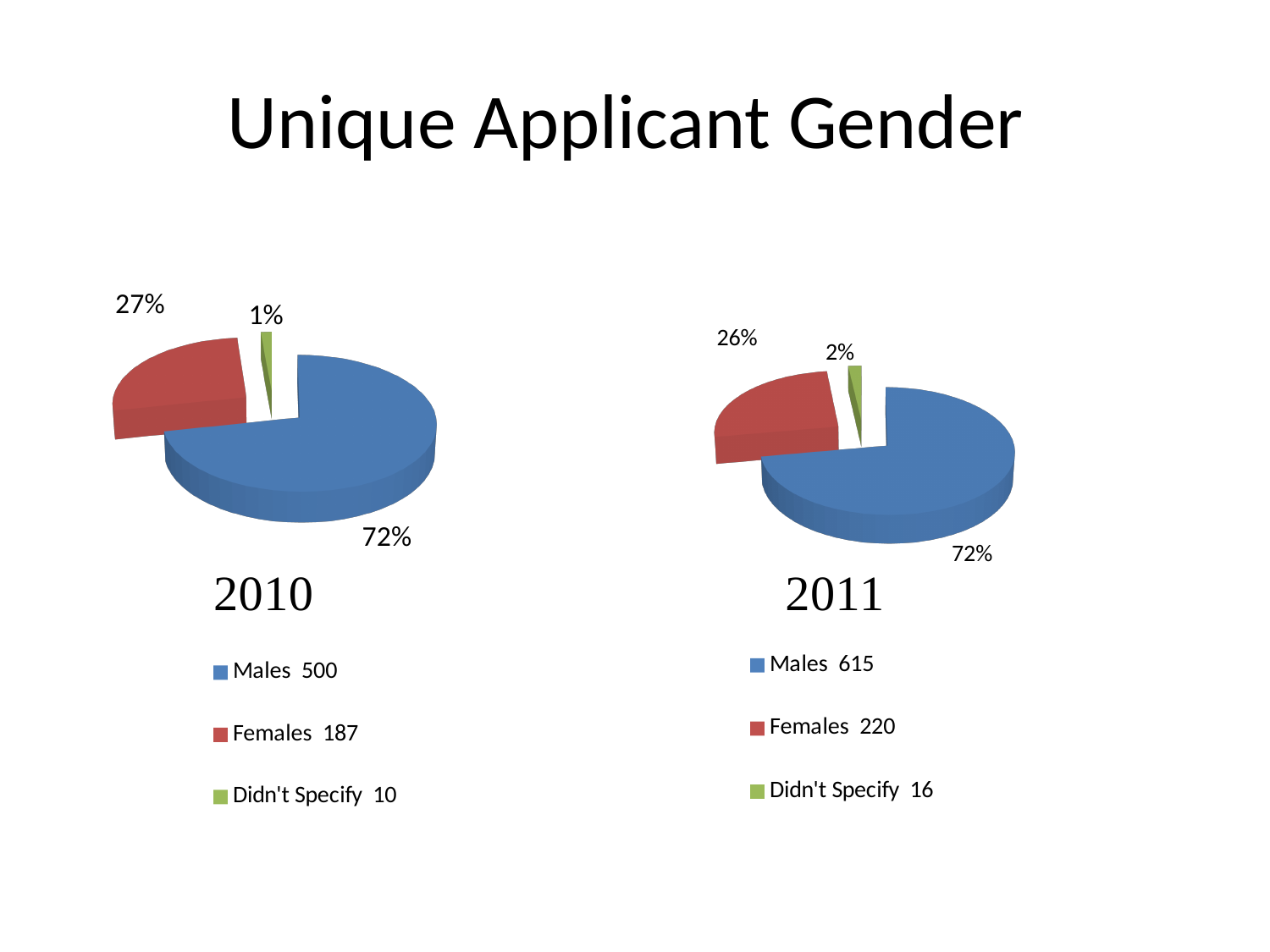
What type of chart is used on this slide? Pie chart In the 2011 chart, what percentage of unique applicants were Females? 26% In the 2011 chart, which category has the largest slice? Males What is the difference between the number of Males in 2011 and the number of Males in 2010, using the legend counts? 115 In the 2010 chart, how many applicants are listed as Males in the legend? 500 In the 2011 chart, how many applicants are listed as Females in the legend? 220 In the 2011 chart, what percentage of unique applicants Didn't Specify their gender? 2% How many categories does each pie chart show? 3 In the 2010 chart, which category has the smallest slice? Didn't Specify In the 2010 chart, what percentage of unique applicants were Females? 27% In the 2011 chart, how many applicants are listed as Didn't Specify in the legend? 16